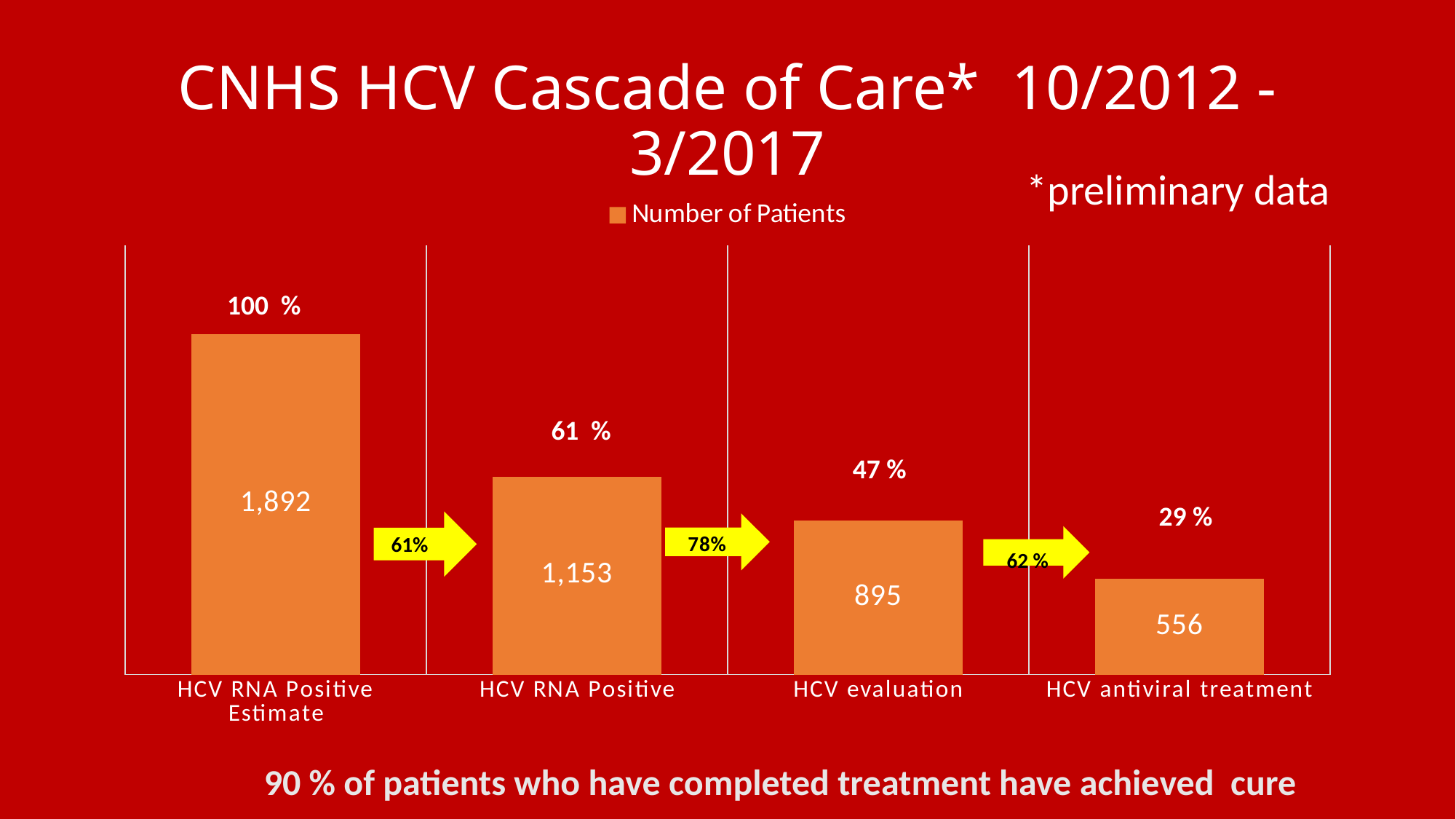
What kind of chart is shown on the slide? Bar chart How many categories are shown on the x axis? 4 How many series does the legend list? 1 What percentage label is shown above the HCV evaluation bar? 47 % Which category has the highest number of patients? HCV RNA Positive Estimate Which category has the lowest number of patients? HCV antiviral treatment Which has more patients, HCV evaluation or HCV antiviral treatment? HCV evaluation What is the number of patients for HCV antiviral treatment? 556 Do the values rise or fall from left to right along the x axis? Fall What is the number of patients for HCV RNA Positive Estimate? 1,892 What is the number of patients for HCV evaluation? 895 What is the difference in number of patients between HCV RNA Positive and HCV evaluation? 258